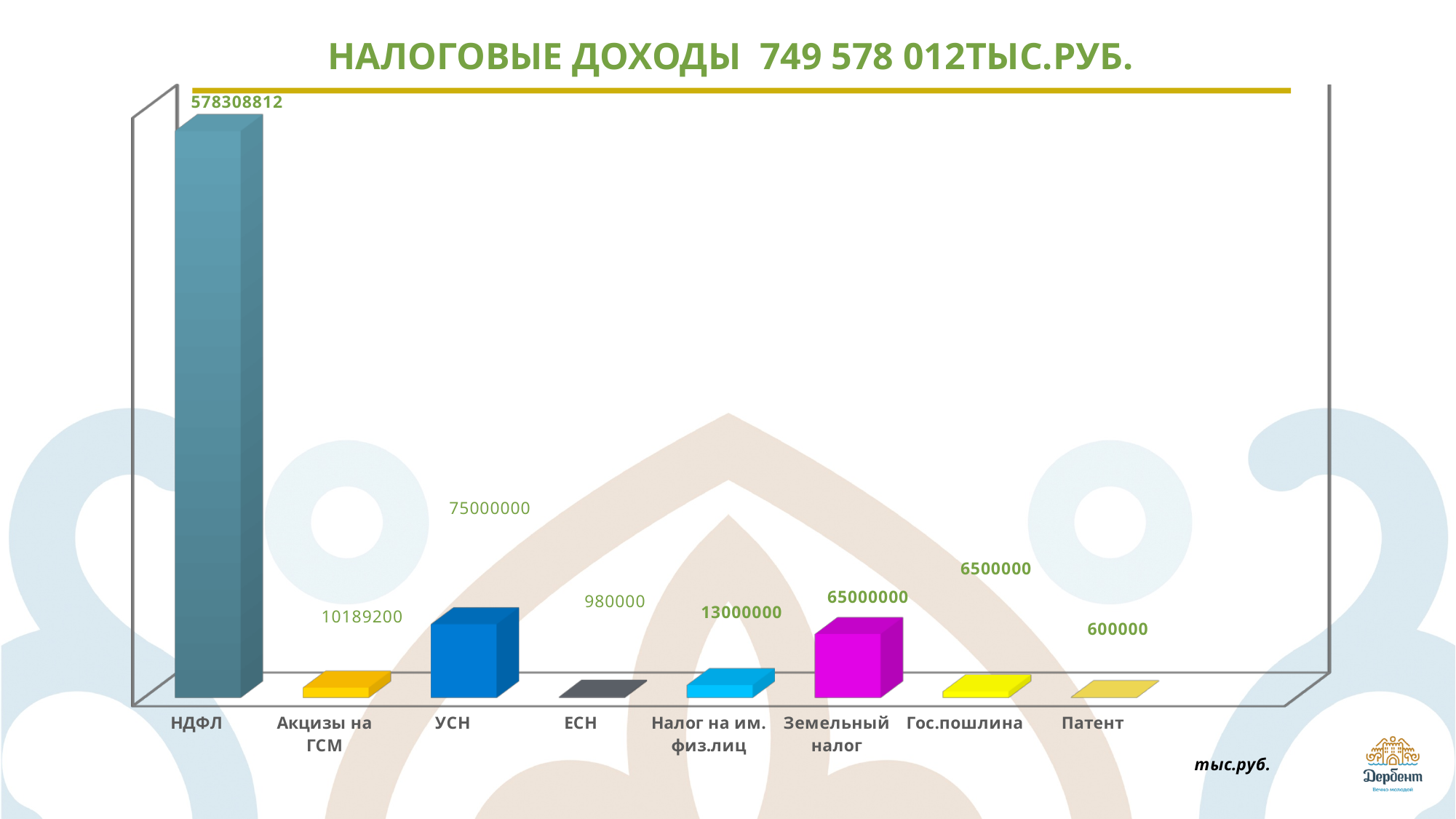
Which category has the lowest value? Патент What is the value for НДФЛ? 578308812 What is the difference between the values for Гос.пошлина and Патент? 5900000 How many categories are shown on the chart? 8 What is the value for Акцизы на ГСМ? 10189200 What is the value for УСН? 75000000 What is the difference between the values for УСН and Земельный налог? 10000000 What type of chart is shown on the slide? bar chart Which is larger, the value for Налог на им. физ.лиц or the value for Акцизы на ГСМ? Налог на им. физ.лиц What is the value for Патент? 600000 What is the value for Земельный налог? 65000000 Which category has the highest value? НДФЛ